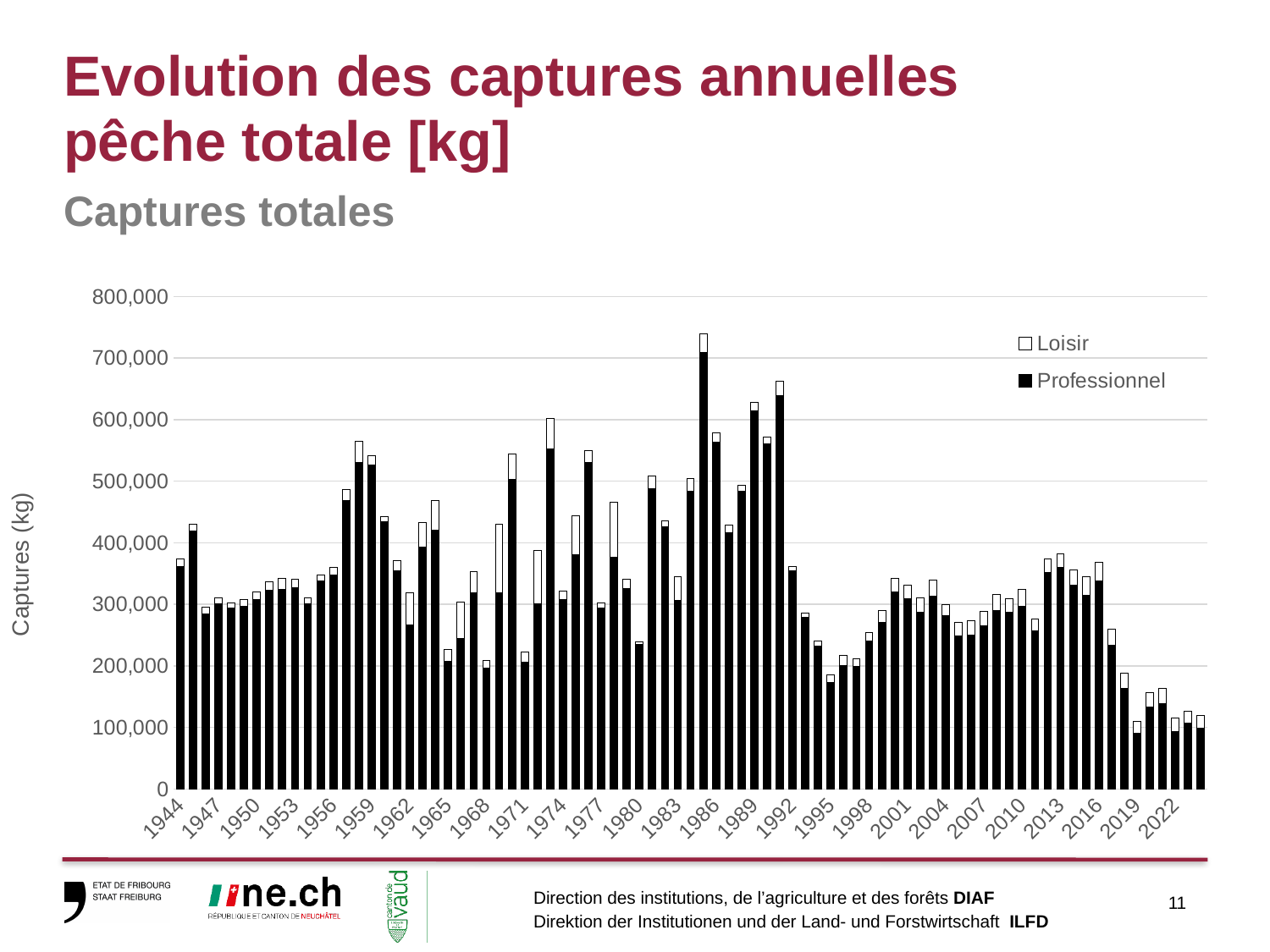
Is the total value for 1944 greater or less than 300,000? greater Is the total value for 2022 greater or less than 200,000? less What are the two series named in the legend? Loisir and Professionnel How many series does the chart legend list? 2 Which year has the larger total catch, 1944 or 2022? 1944 Do the total catches generally rise or fall between 2013 and 2022? fall Is the total value for 1974 greater or less than 500,000? less What kind of chart is shown on the slide? Stacked bar chart What is the label on the vertical axis of the chart? Captures (kg) Which year has the larger total catch, 1986 or 2013? 1986